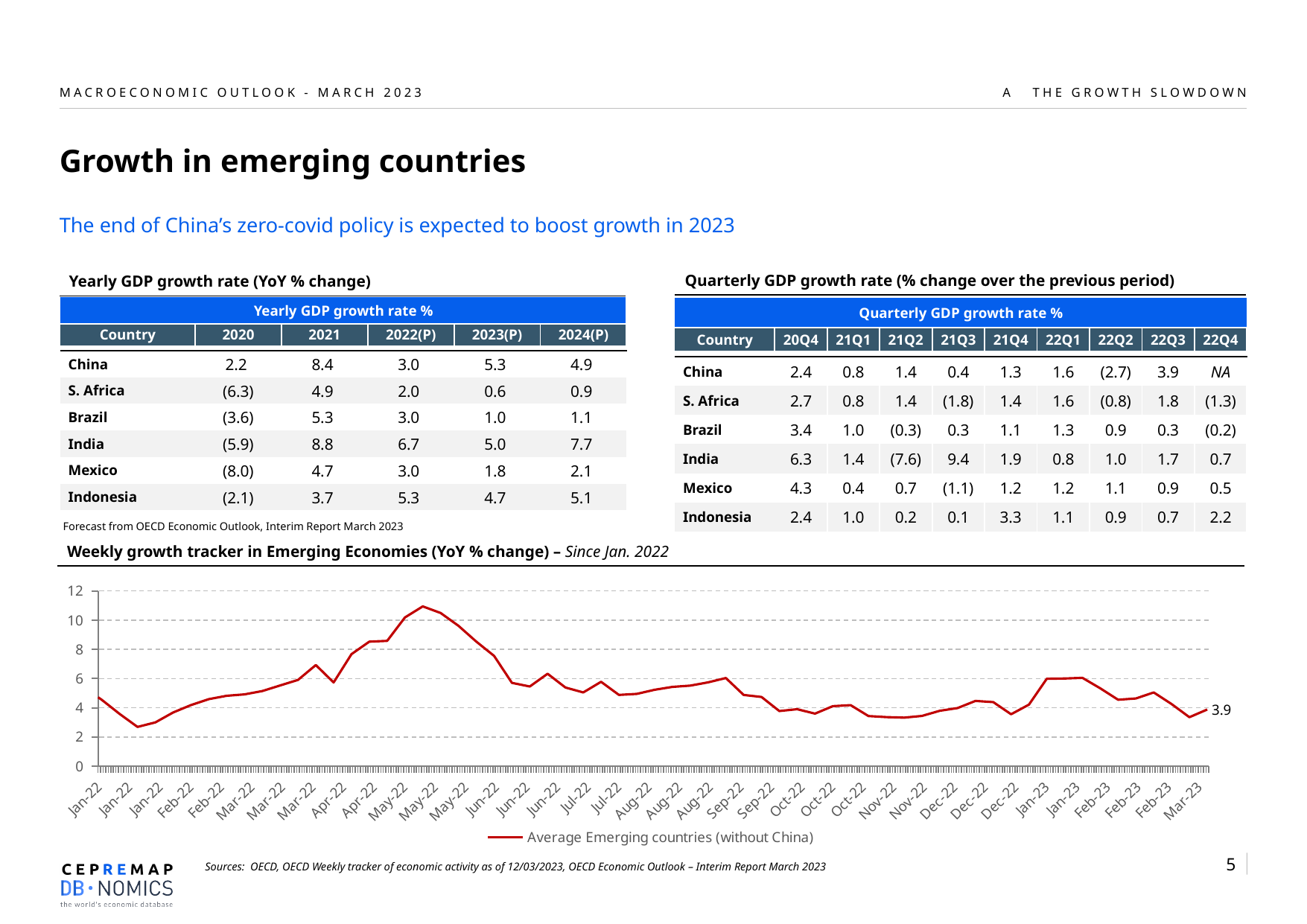
Is the value of the weekly growth tracker at the start of Jan-22 greater or less than 6? less What is the name of the series shown in the weekly growth tracker chart? Average Emerging countries (without China) Does the weekly growth tracker line rise or fall between May-22 and Mar-23? fall What kind of chart is the weekly growth tracker in Emerging Economies? line chart In which month does the weekly growth tracker line reach its highest point? May-22 Is the peak value of the weekly growth tracker in May-22 greater or less than 10? greater How many series does the legend of the weekly growth tracker chart list? 1 Which is higher on the weekly growth tracker: the value in May-22 or the value in Mar-23? May-22 What is the highest value shown on the y axis of the weekly growth tracker chart? 12 Is the value of the weekly growth tracker in Nov-22 greater or less than 4? less What is the last labelled value on the weekly growth tracker line, at Mar-23? 3.9